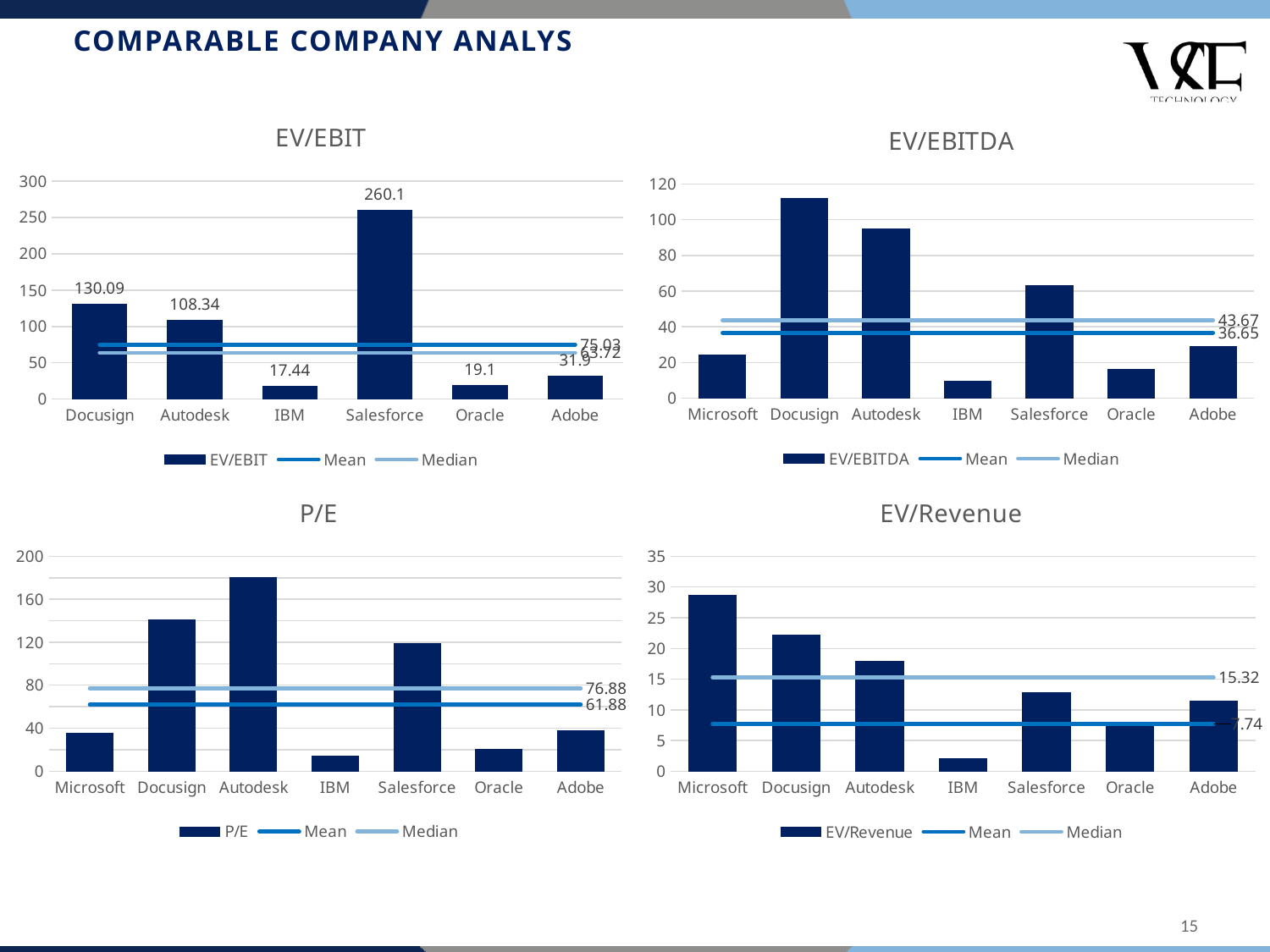
How many companies are shown in the EV/EBITDA chart? 7 In the EV/EBIT chart, which company has the lowest EV/EBIT? IBM In the P/E chart, is the value for Autodesk greater or less than 160? greater In the EV/EBITDA chart, what is the value of the Median line? 43.67 In the EV/EBITDA chart, which company has the highest EV/EBITDA? Docusign How many series does the legend of the P/E chart list? 3 In the EV/EBIT chart, what is the difference between the EV/EBIT values of Docusign and Autodesk? 21.75 In the EV/EBIT chart, what is the EV/EBIT value for Salesforce? 260.1 In the EV/EBIT chart, what is the value of the Mean line? 75.03 In the EV/EBIT chart, which company has the highest EV/EBIT? Salesforce In the P/E chart, which has the larger P/E value, Docusign or Salesforce? Docusign In the EV/Revenue chart, which company has the lowest EV/Revenue? IBM